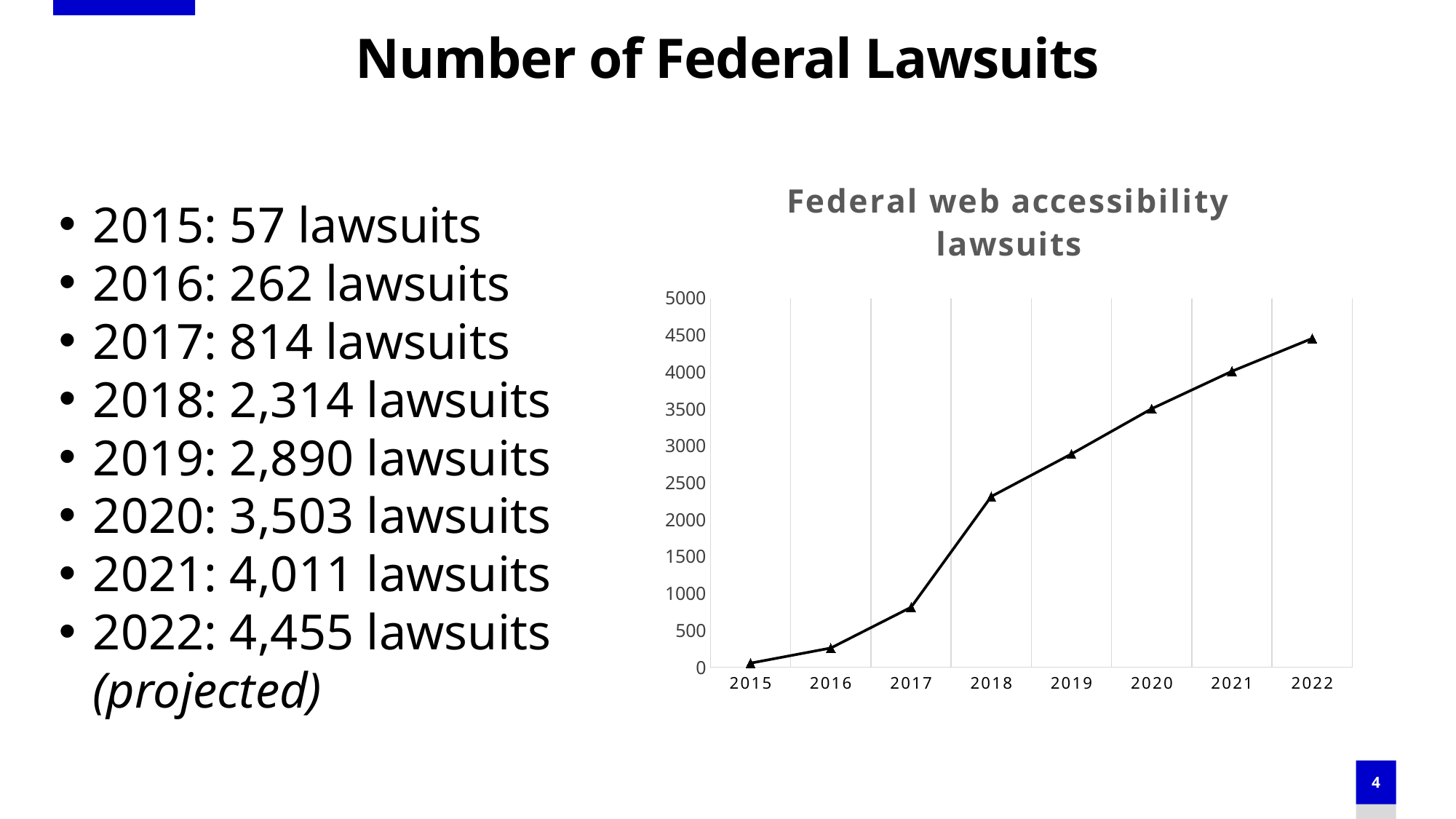
Is the value for 2022 greater or less than 4000? greater According to the slide, how many federal lawsuits were there in 2020? 3,503 lawsuits What type of chart is shown on the slide? line chart Is the value for 2017 greater or less than 1000? less How many years are plotted on the x axis of the chart? 8 According to the slide, what is the difference between the number of lawsuits in 2022 and 2021? 444 Do the values in the chart rise or fall from 2015 to 2022? rise Which year has more lawsuits, 2019 or 2021? 2021 What is the title of the chart? Federal web accessibility lawsuits Is the value for 2018 greater or less than 2000? greater Which year has the lowest number of federal web accessibility lawsuits? 2015 Which year has the highest number of federal web accessibility lawsuits? 2022